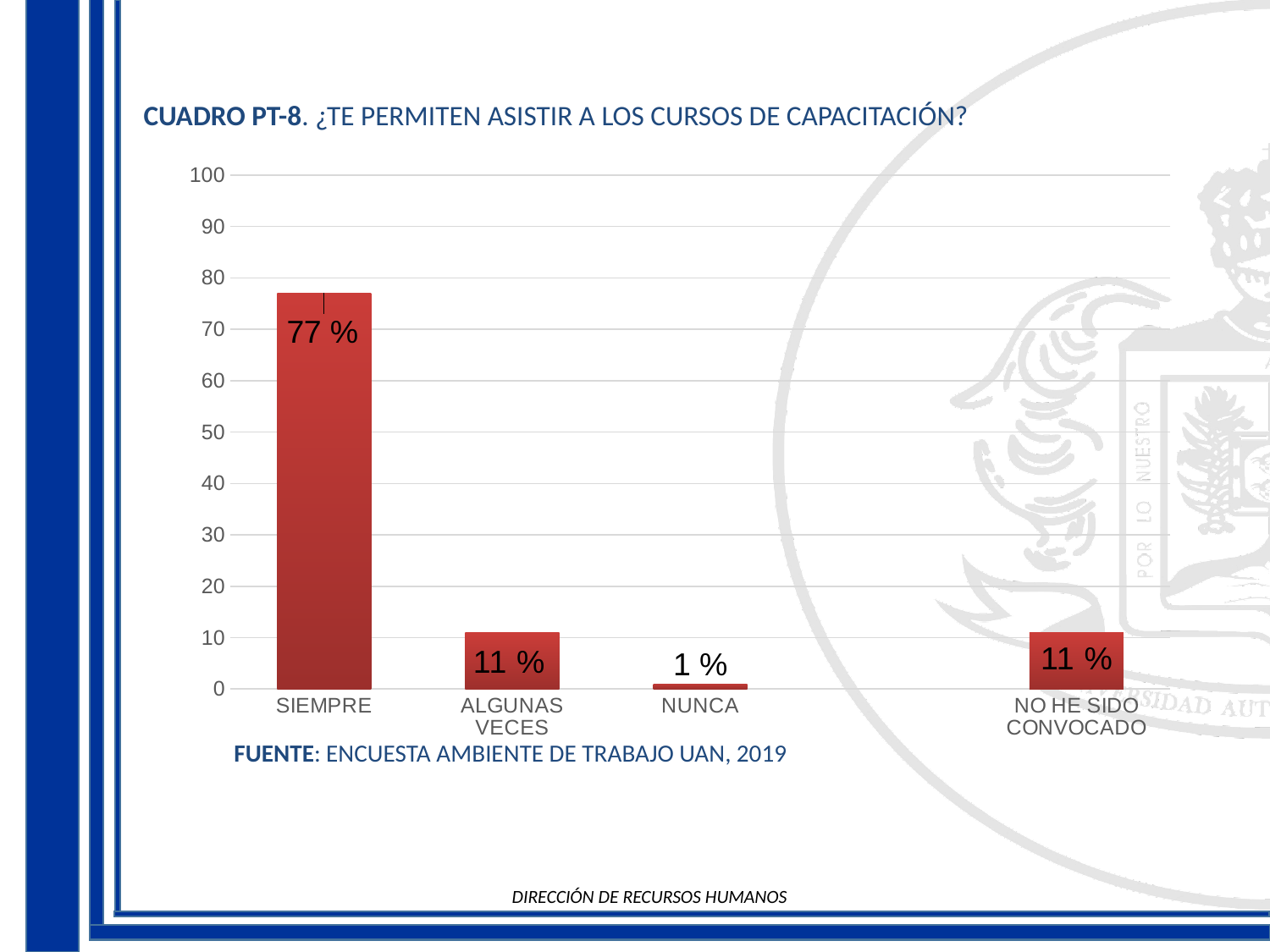
What is the value for SIEMPRE? 77 % What is the title of the chart? CUADRO PT-8. ¿TE PERMITEN ASISTIR A LOS CURSOS DE CAPACITACIÓN? Which category has the highest value? SIEMPRE What is the value for NUNCA? 1 % Is the value for SIEMPRE greater or less than 70? greater What is the difference between the values for ALGUNAS VECES and NUNCA? 10 % How many categories are shown on the x axis? 4 What is the difference between the values for SIEMPRE and ALGUNAS VECES? 66 % What is the value for NO HE SIDO CONVOCADO? 11 % Which category has the lowest value? NUNCA Which is larger, the value for SIEMPRE or the value for NO HE SIDO CONVOCADO? SIEMPRE What kind of chart is shown on the slide? bar chart